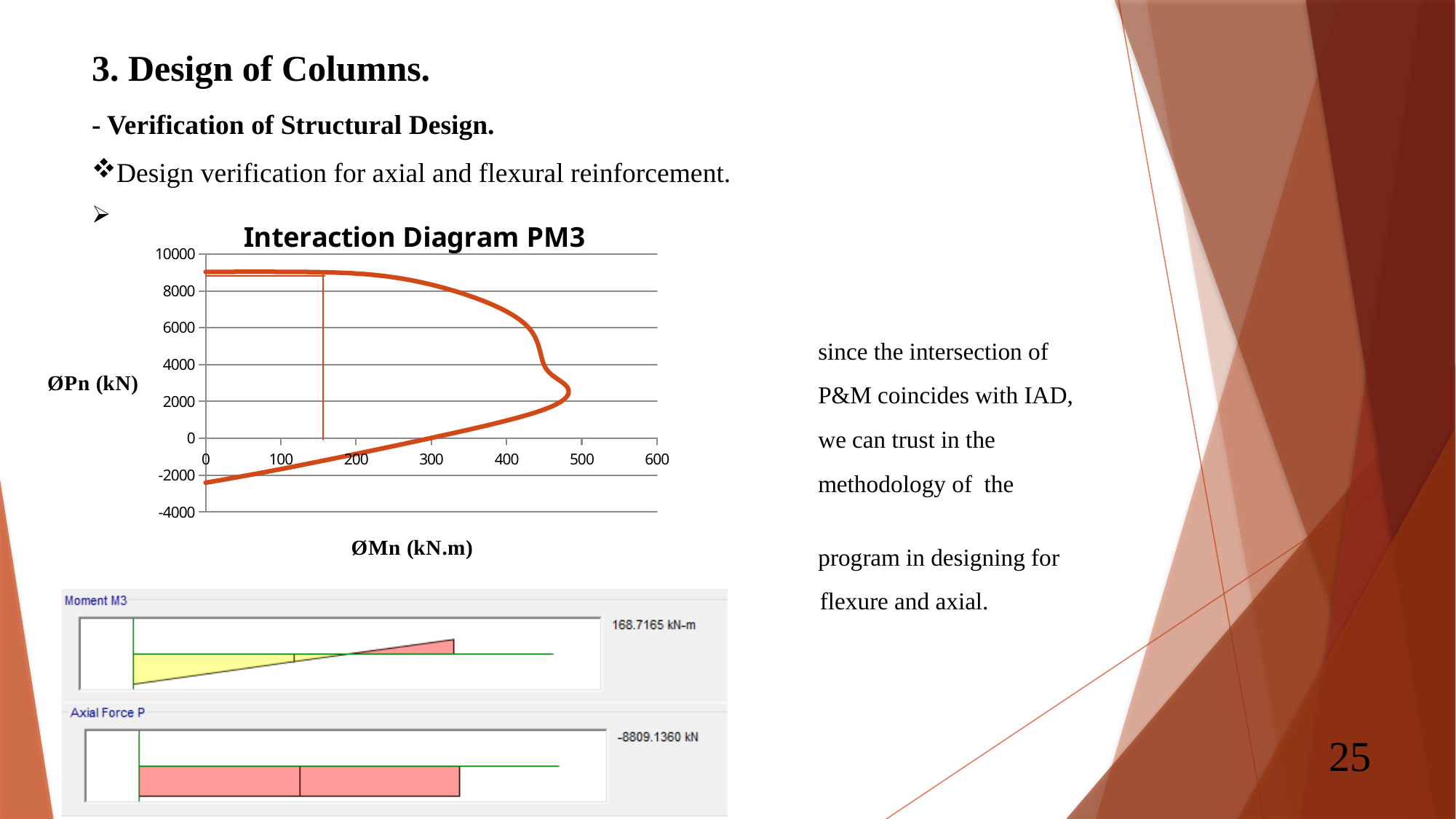
What is the label of the vertical axis of the Interaction Diagram PM3 chart? ØPn (kN) In the Interaction Diagram PM3 chart, does the lower branch of the curve rise or fall as ØMn increases from 0 to 400? rise In the Interaction Diagram PM3 chart, does the upper branch of the curve rise or fall as ØMn increases from 0 to 400? fall In the Interaction Diagram PM3 chart, is the ØMn position of the thin vertical line greater or less than 100? greater What kind of chart is the Interaction Diagram PM3? line chart In the Interaction Diagram PM3 chart, is the largest ØMn value reached by the curve greater or less than 500? less In the Interaction Diagram PM3 chart, is the lowest ØPn value reached by the curve greater or less than -2000? less What is the title of the chart on the slide? Interaction Diagram PM3